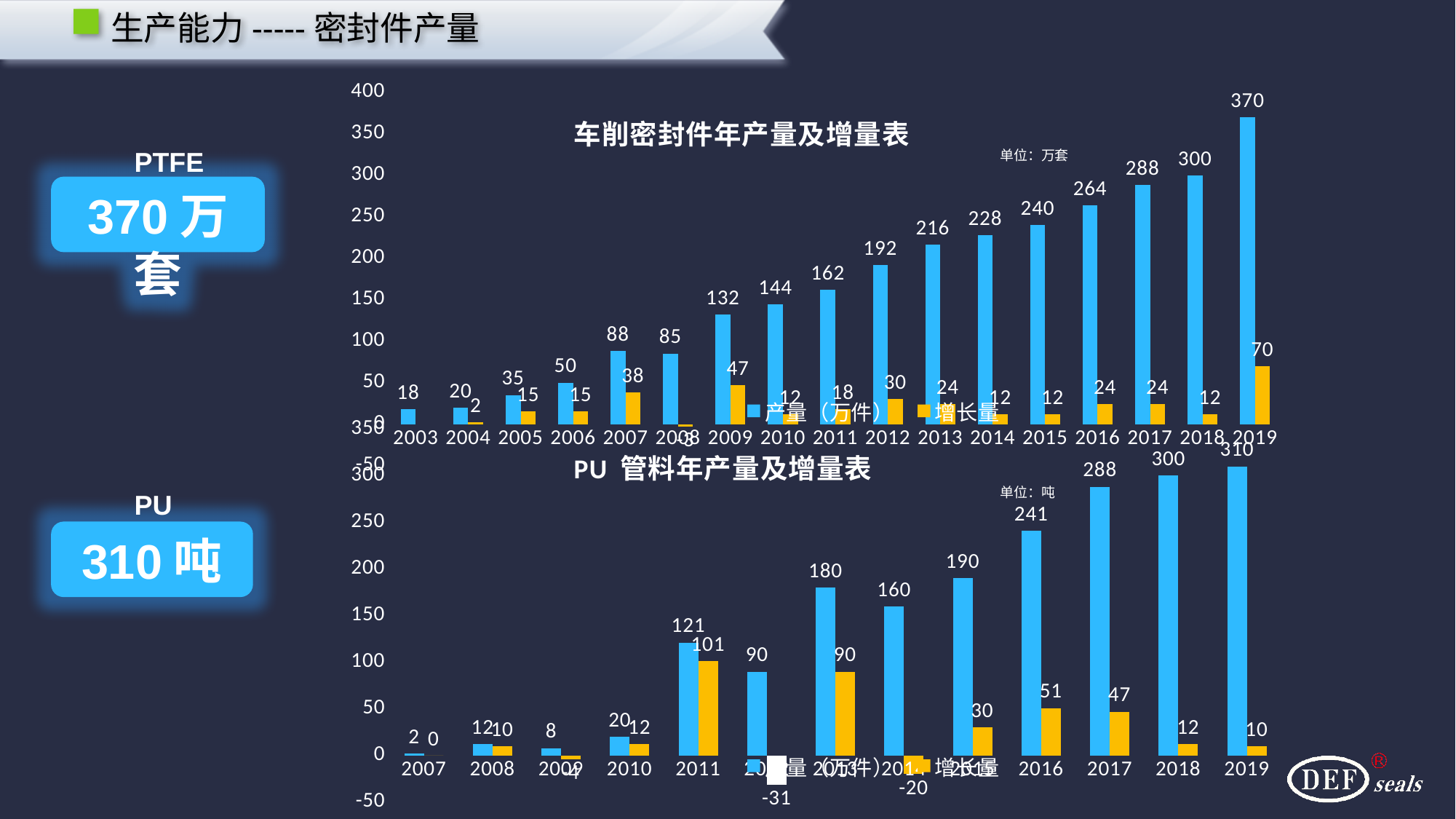
In the top chart (车削密封件年产量及增量表), what is the production value for 2019? 370 In the bottom chart (PU 管料年产量及增量表), which year has the highest growth value (增长量)? 2011 In the bottom chart (PU 管料年产量及增量表), what is the difference between the production values for 2013 and 2012? 90 In the top chart (车削密封件年产量及增量表), what is the difference between the production values for 2019 and 2018? 70 In the top chart (车削密封件年产量及增量表), which is larger, the production value for 2007 or for 2008? 2007 In the top chart (车削密封件年产量及增量表), how many years are shown on the x axis? 17 In the top chart (车削密封件年产量及增量表), what is the growth value (增长量) for 2009? 47 In the top chart (车削密封件年产量及增量表), which year has the highest production value? 2019 In the bottom chart (PU 管料年产量及增量表), what is the growth value (增长量) for 2012? -31 In the bottom chart (PU 管料年产量及增量表), what is the production value for 2016? 241 In the bottom chart (PU 管料年产量及增量表), how many series does the legend list? 2 What type of chart is the bottom chart (PU 管料年产量及增量表)? Bar chart